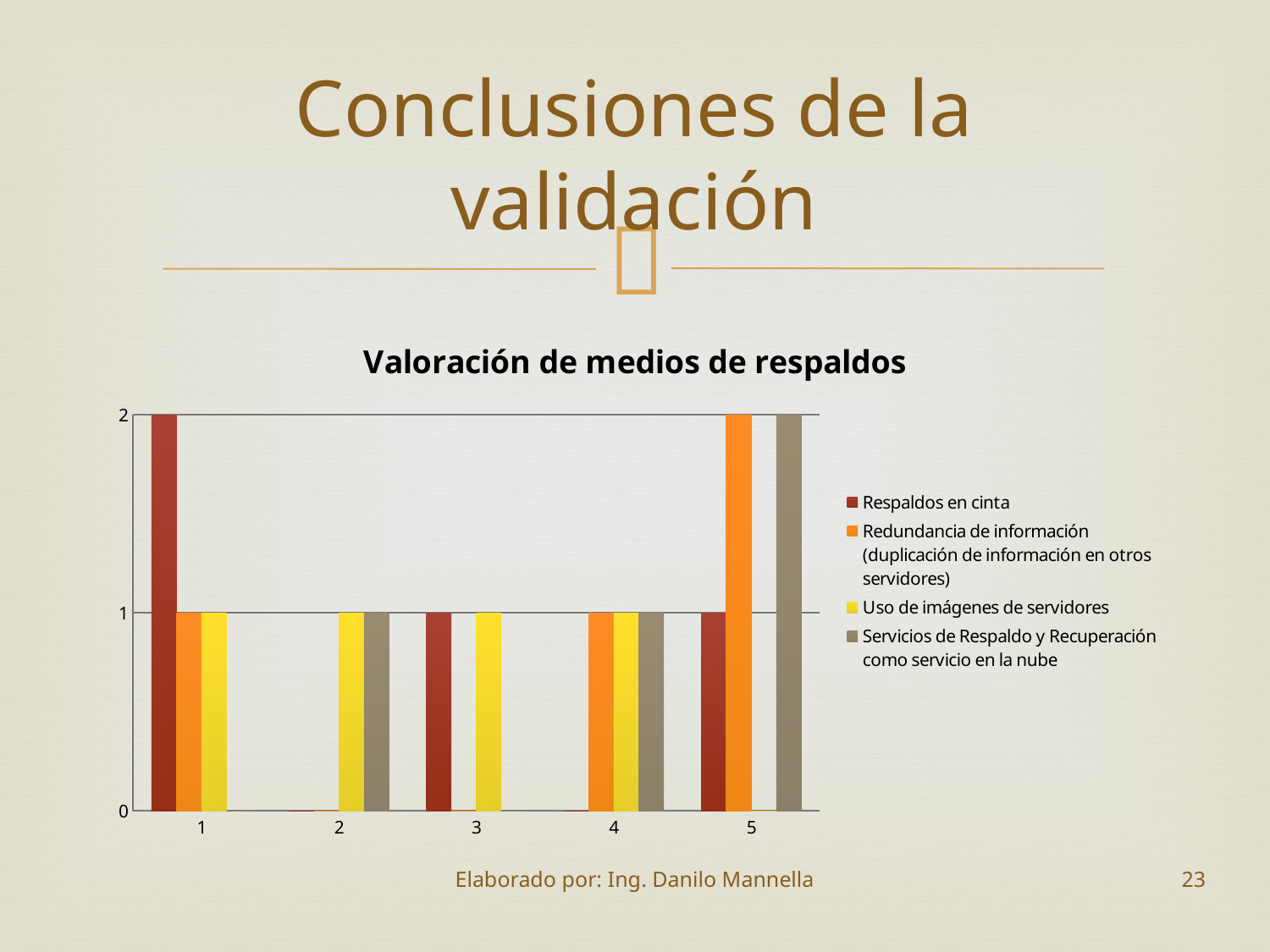
What is the value for Uso de imágenes de servidores at category 3? 1 What is the value for Servicios de Respaldo y Recuperación como servicio en la nube at category 5? 2 Which series is shown in yellow in the legend? Uso de imágenes de servidores At which category is the value for Respaldos en cinta highest? 1 What kind of chart is shown on the slide? bar chart What is the value for Redundancia de información (duplicación de información en otros servidores) at category 5? 2 How many series does the legend list? 4 What is the difference between Respaldos en cinta and Uso de imágenes de servidores at category 1? 1 What is the value for Respaldos en cinta at category 1? 2 What is the title of the chart? Valoración de medios de respaldos How many categories are shown on the x axis? 5 Which is larger at category 5: Respaldos en cinta or Redundancia de información (duplicación de información en otros servidores)? Redundancia de información (duplicación de información en otros servidores)